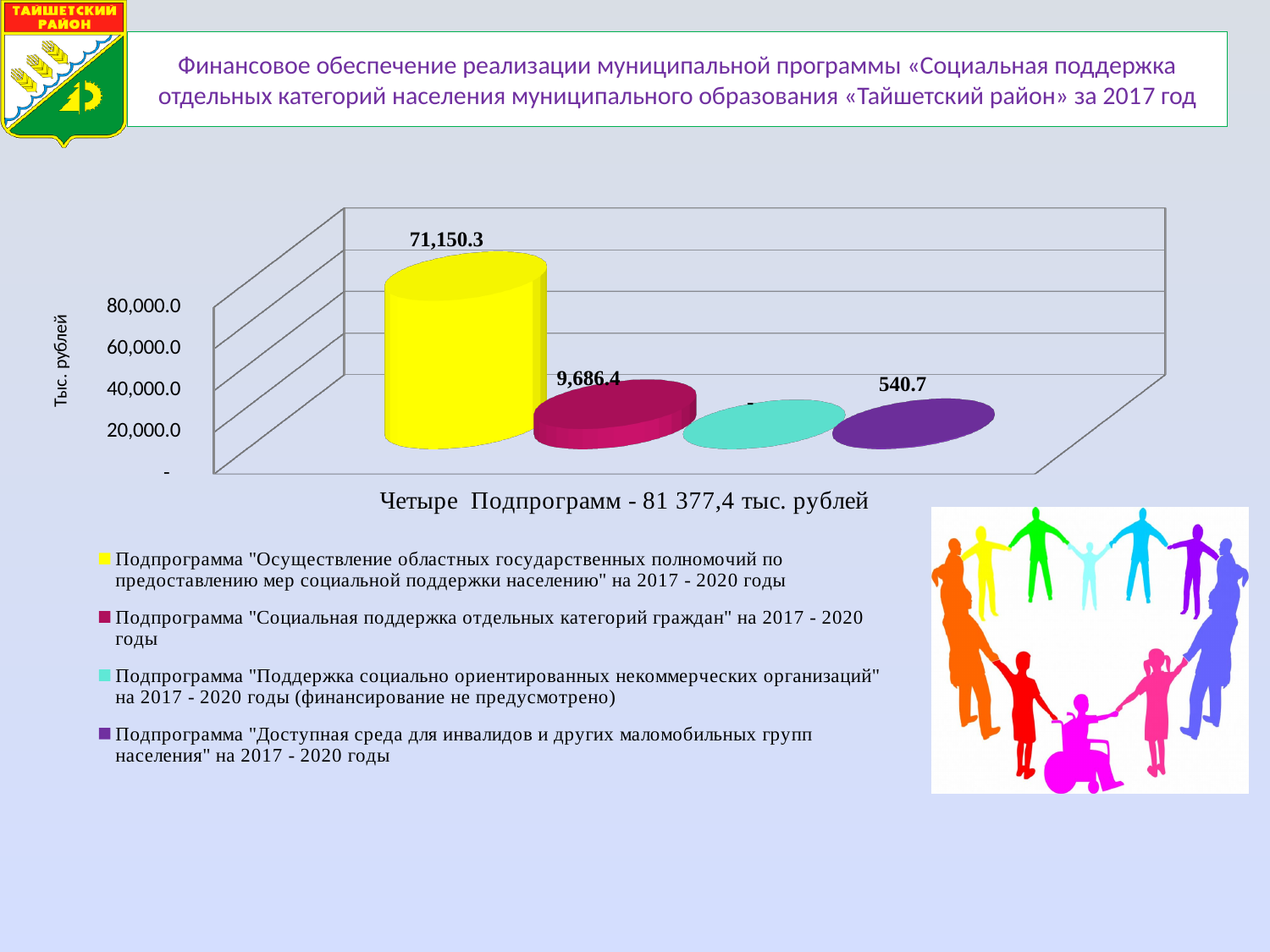
What is the difference between the values for the yellow bar (71,150.3) and the magenta bar (9,686.4)? 61,463.9 Which subprogram has the highest value on the chart? Подпрограмма "Осуществление областных государственных полномочий по предоставлению мер социальной поддержки населению" What is the value shown for the subprogram "Социальная поддержка отдельных категорий граждан" (magenta bar)? 9,686.4 Which is larger: the value for the magenta bar or the value for the purple bar? The magenta bar (9,686.4) What kind of chart is shown on the slide? Bar chart What unit is shown on the vertical axis of the chart? Тыс. рублей How many series does the legend list? 4 Is the value for the yellow bar greater or less than 60,000.0? greater What is the value shown for the subprogram "Осуществление областных государственных полномочий по предоставлению мер социальной поддержки населению" (yellow bar)? 71,150.3 What is the value shown for the subprogram "Доступная среда для инвалидов и других маломобильных групп населения" (purple bar)? 540.7 Which subprogram has no funding shown on the chart (value "-")? Подпрограмма "Поддержка социально ориентированных некоммерческих организаций" According to the caption under the chart, what is the total for the four subprograms? 81 377,4 тыс. рублей